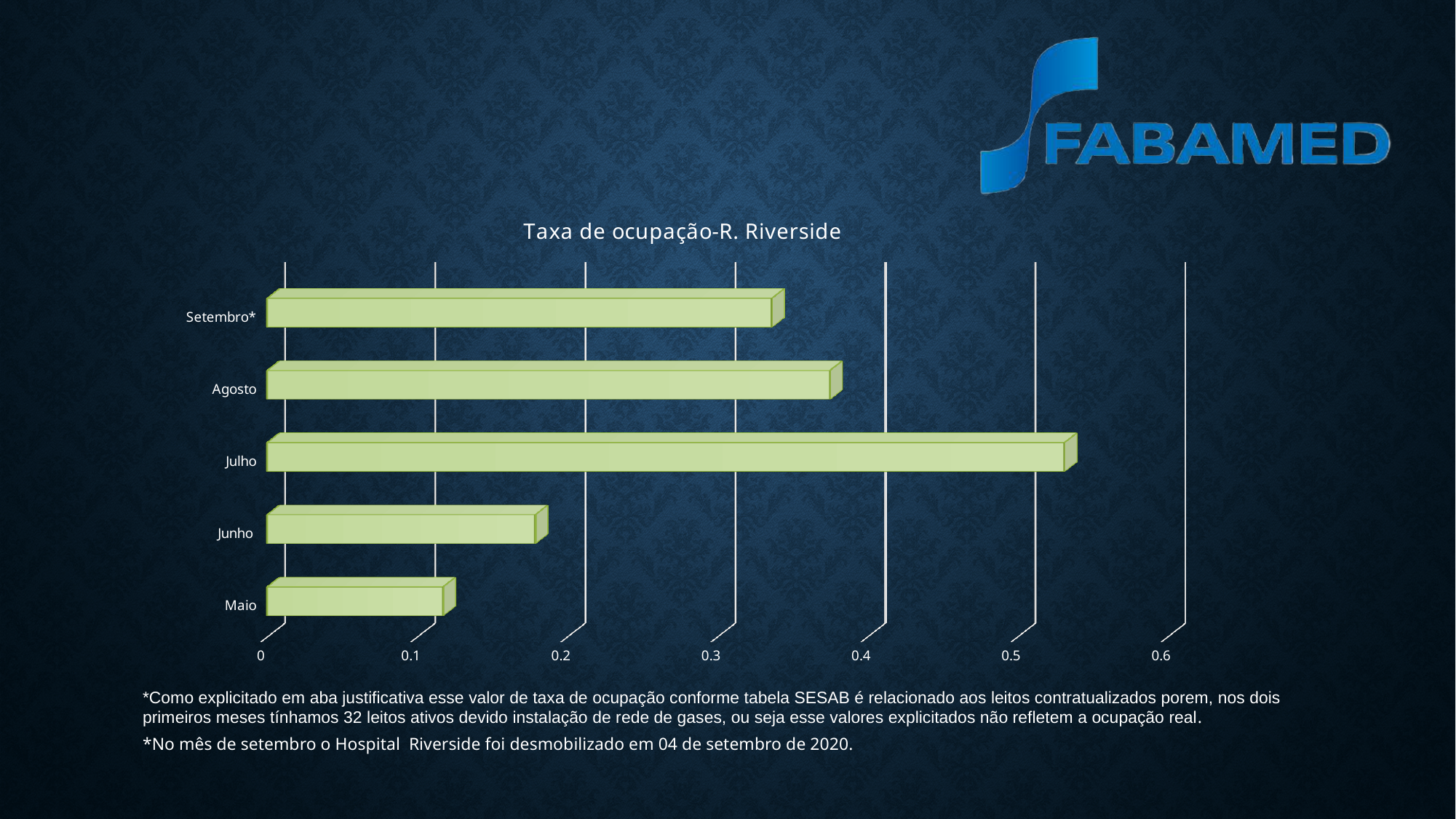
Is the value for Julho greater or less than 0.5? greater Is the value for Setembro* greater or less than 0.3? greater Do the values rise or fall from Maio to Julho? rise How many months (categories) are plotted in the chart? 5 Is the value for Junho greater or less than 0.2? less What is the title of the chart? Taxa de ocupação-R. Riverside Which month has the highest occupancy rate? Julho Which has the larger value, Agosto or Setembro*? Agosto Which month has the lowest occupancy rate? Maio What kind of chart is shown on the slide? Bar chart Which has the larger value, Junho or Setembro*? Setembro*